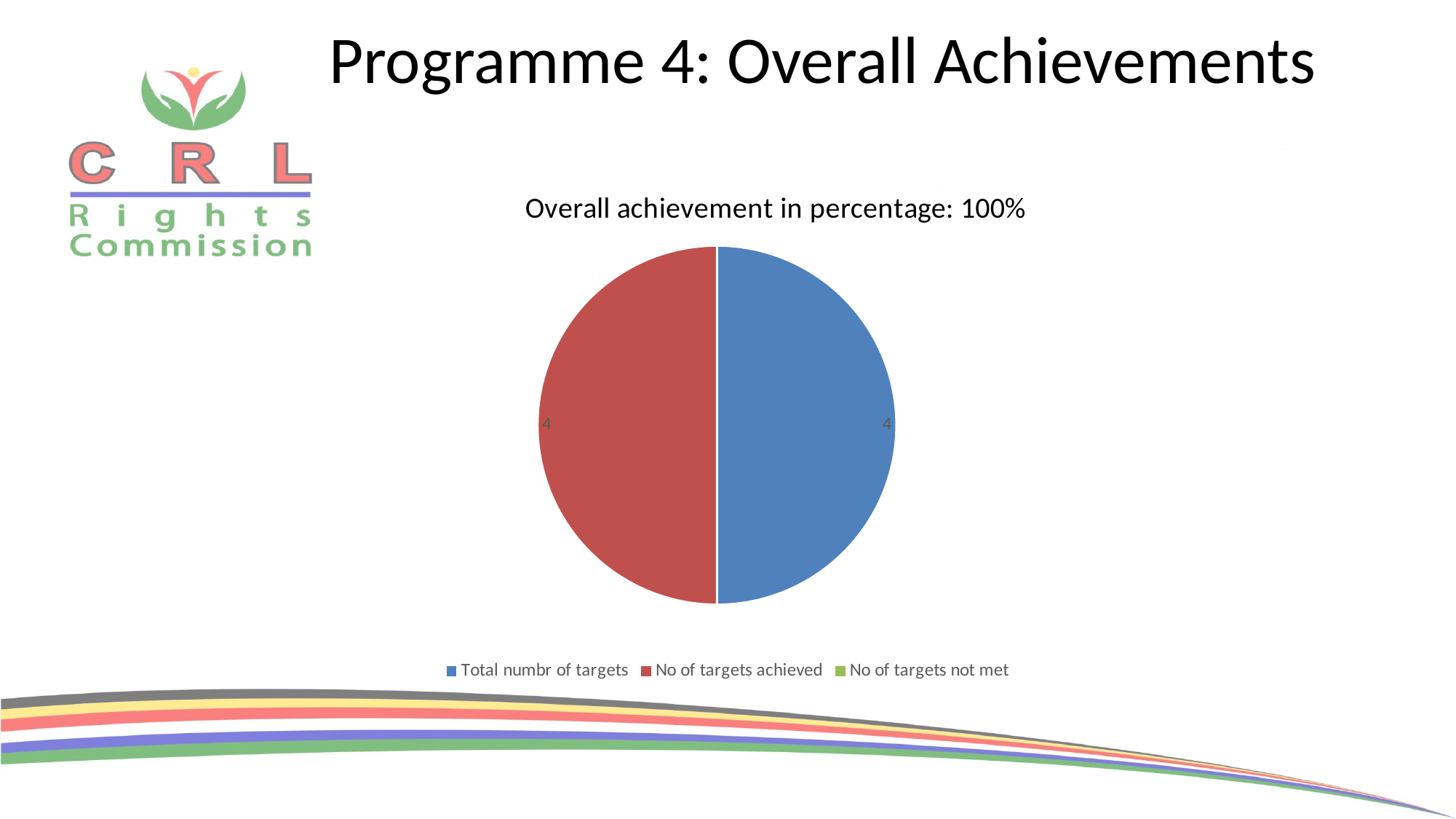
What value is shown for the 'No of targets achieved' slice? 4 What is the sum of the two labelled slice values? 8 What is the title of the chart? Overall achievement in percentage: 100% What is the difference between the 'Total numbr of targets' value and the 'No of targets achieved' value? 0 What share of the pie does the 'No of targets achieved' slice take up? 50% What share of the pie does the 'Total numbr of targets' slice take up? 50% How many entries does the legend list? 3 What kind of chart is shown on the slide? pie chart How many slices are visible in the pie chart? 2 What value is shown for the 'Total numbr of targets' slice? 4 Which legend entry has no visible slice in the pie chart? No of targets not met